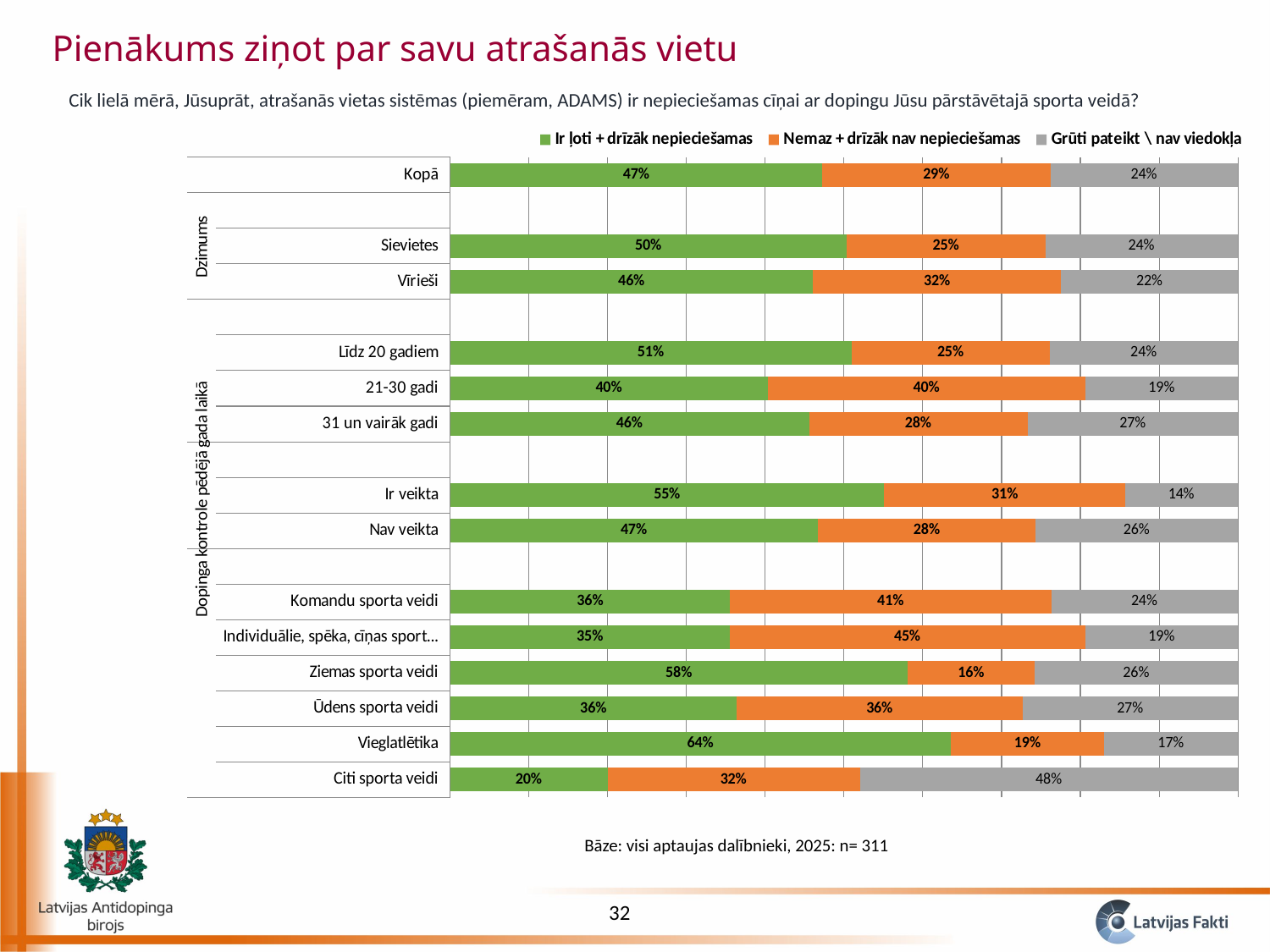
What is the total of the stacked bar for 'Sievietes'? 99% What is the difference in percentage points between the 'Ir ļoti + drīzāk nepieciešamas' values for 'Vieglatlētika' and 'Citi sporta veidi'? 44 percentage points How many series does the legend list? 3 Which has a larger 'Nemaz + drīzāk nav nepieciešamas' value: 'Komandu sporta veidi' or 'Ziemas sporta veidi'? Komandu sporta veidi Which category has the lowest 'Grūti pateikt \ nav viedokļa' value? Ir veikta What percentage of 'Kopā' respondents answered 'Ir ļoti + drīzāk nepieciešamas'? 47% What is the 'Grūti pateikt \ nav viedokļa' value for 'Citi sporta veidi'? 48% Which category has the highest 'Ir ļoti + drīzāk nepieciešamas' value? Vieglatlētika What kind of chart is shown on the slide? Stacked bar chart How many categories (bars) are shown in the chart? 14 Which category has the lowest 'Ir ļoti + drīzāk nepieciešamas' value? Citi sporta veidi What is the 'Nemaz + drīzāk nav nepieciešamas' value for 'Vīrieši'? 32%